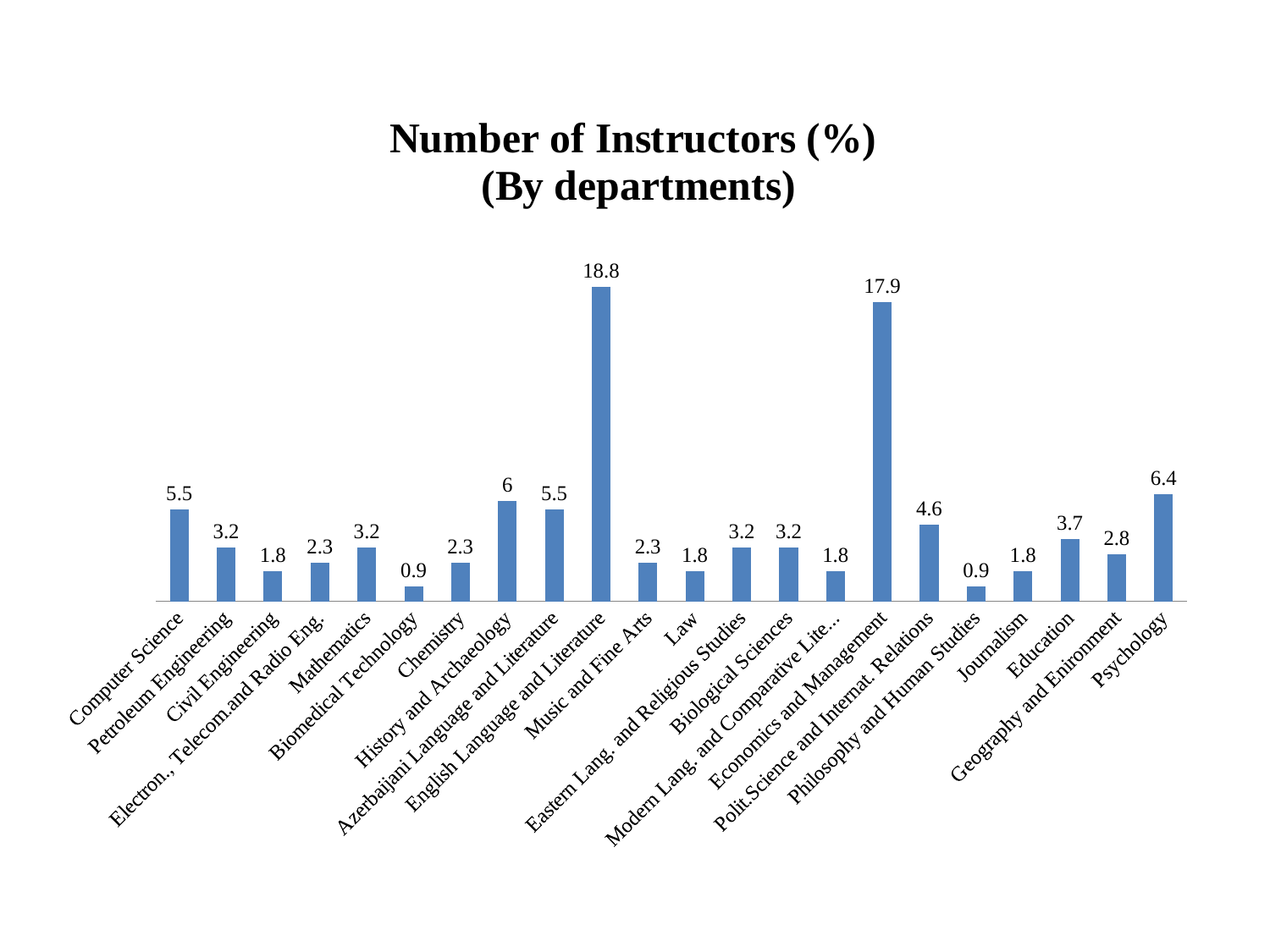
What is the difference between the values for Psychology and Computer Science? 0.9 What is the value for Psychology? 6.4 Which department has the highest value? English Language and Literature What kind of chart is shown on the slide? Bar chart What is the value for Polit.Science and Internat. Relations? 4.6 What is the title of the chart? Number of Instructors (%) (By departments) What is the value for Biomedical Technology? 0.9 Which is larger, the value for History and Archaeology or the value for Education? History and Archaeology What is the value for English Language and Literature? 18.8 How many departments are shown in the chart? 22 What is the value for Economics and Management? 17.9 What is the difference between the values for English Language and Literature and Economics and Management? 0.9